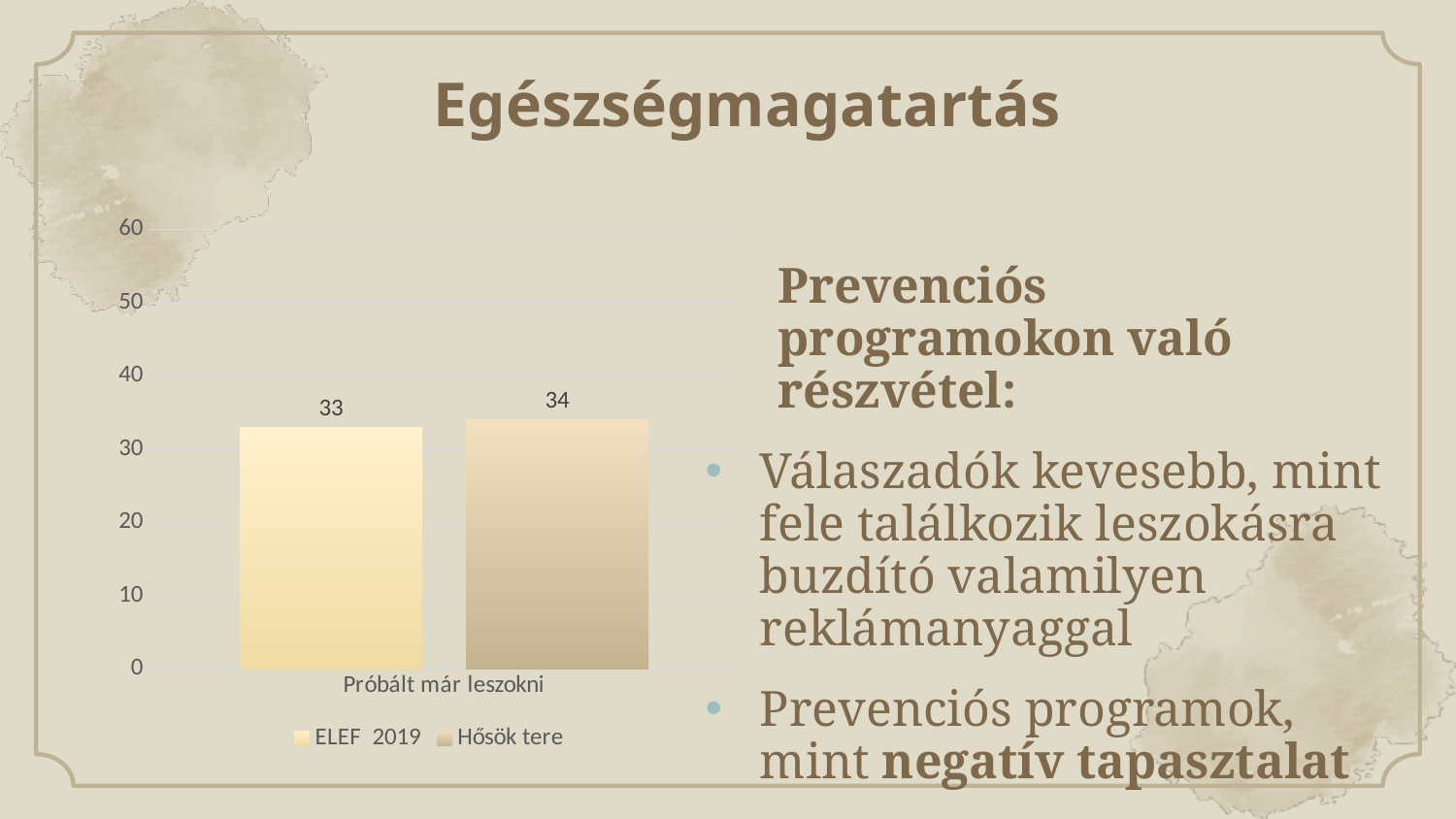
Which series has the lowest value in the chart? ELEF 2019 What is the highest value shown on the y axis of the chart? 60 What is the value for ELEF 2019 in the category Próbált már leszokni? 33 Which series has the higher value for Próbált már leszokni, ELEF 2019 or Hősök tere? Hősök tere How many categories are shown on the x axis of the chart? 1 Is the value for Hősök tere greater or less than 30? greater What is the value for Hősök tere in the category Próbált már leszokni? 34 Is the value for ELEF 2019 greater or less than 40? less What is the difference between the Hősök tere value and the ELEF 2019 value for Próbált már leszokni? 1 What is the label of the category on the x axis? Próbált már leszokni How many series does the legend list? 2 What kind of chart is shown on the slide? bar chart